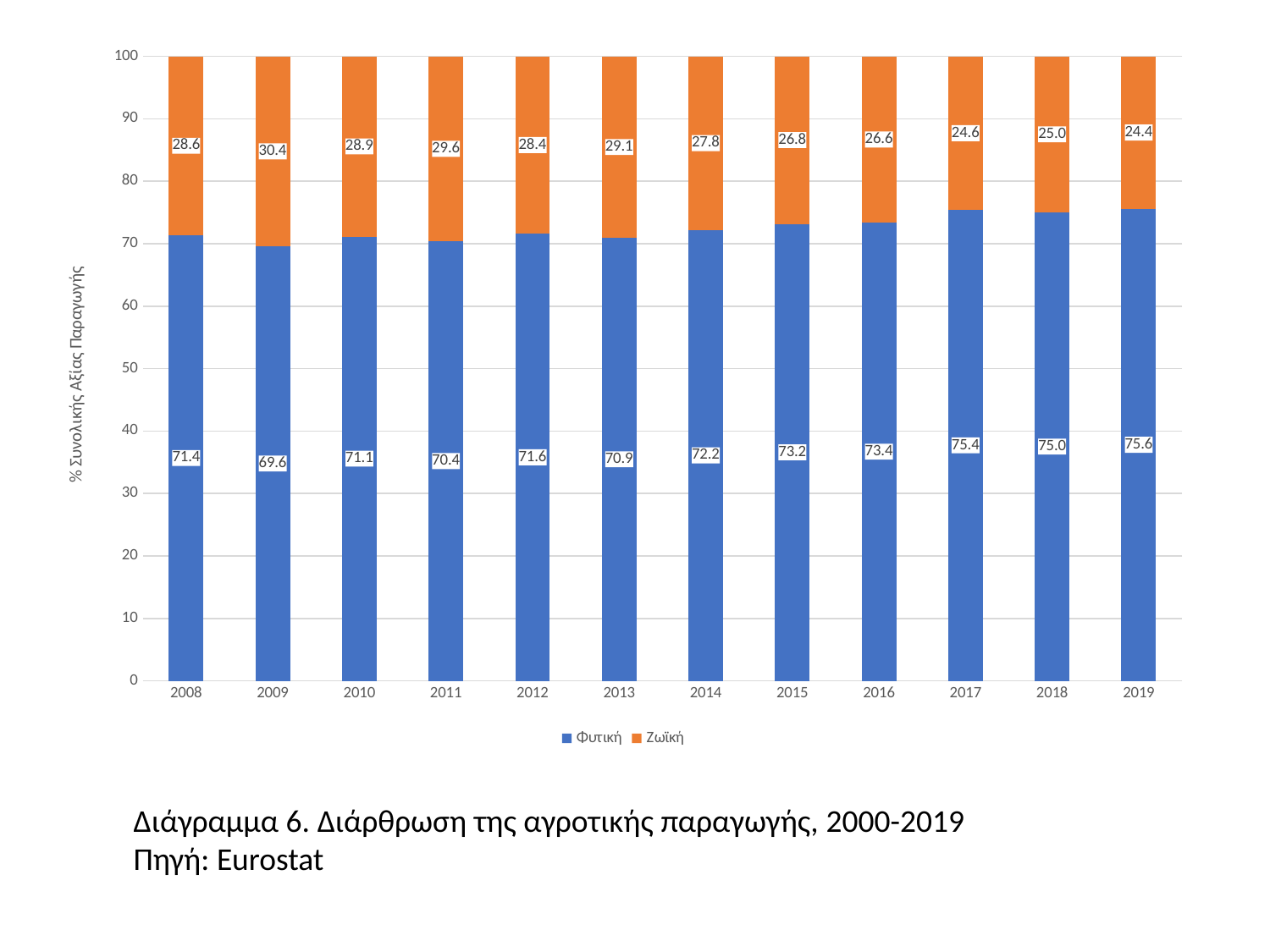
What is the value for Φυτική in 2008? 71.4 What is the value for Ζωϊκή in 2009? 30.4 How many years are shown on the x axis? 12 What kind of chart is shown? Stacked bar chart What is the total of the stacked bar for 2018? 100 Does the Ζωϊκή value rise or fall from 2013 to 2019? Fall How many series does the legend list? 2 Which is larger, the Ζωϊκή value in 2011 or in 2017? 2011 What is the value for Φυτική in 2019? 75.6 What is the difference between the Φυτική values for 2019 and 2008? 4.2 In which year is the Φυτική value lowest? 2009 In which year is the Ζωϊκή value highest? 2009